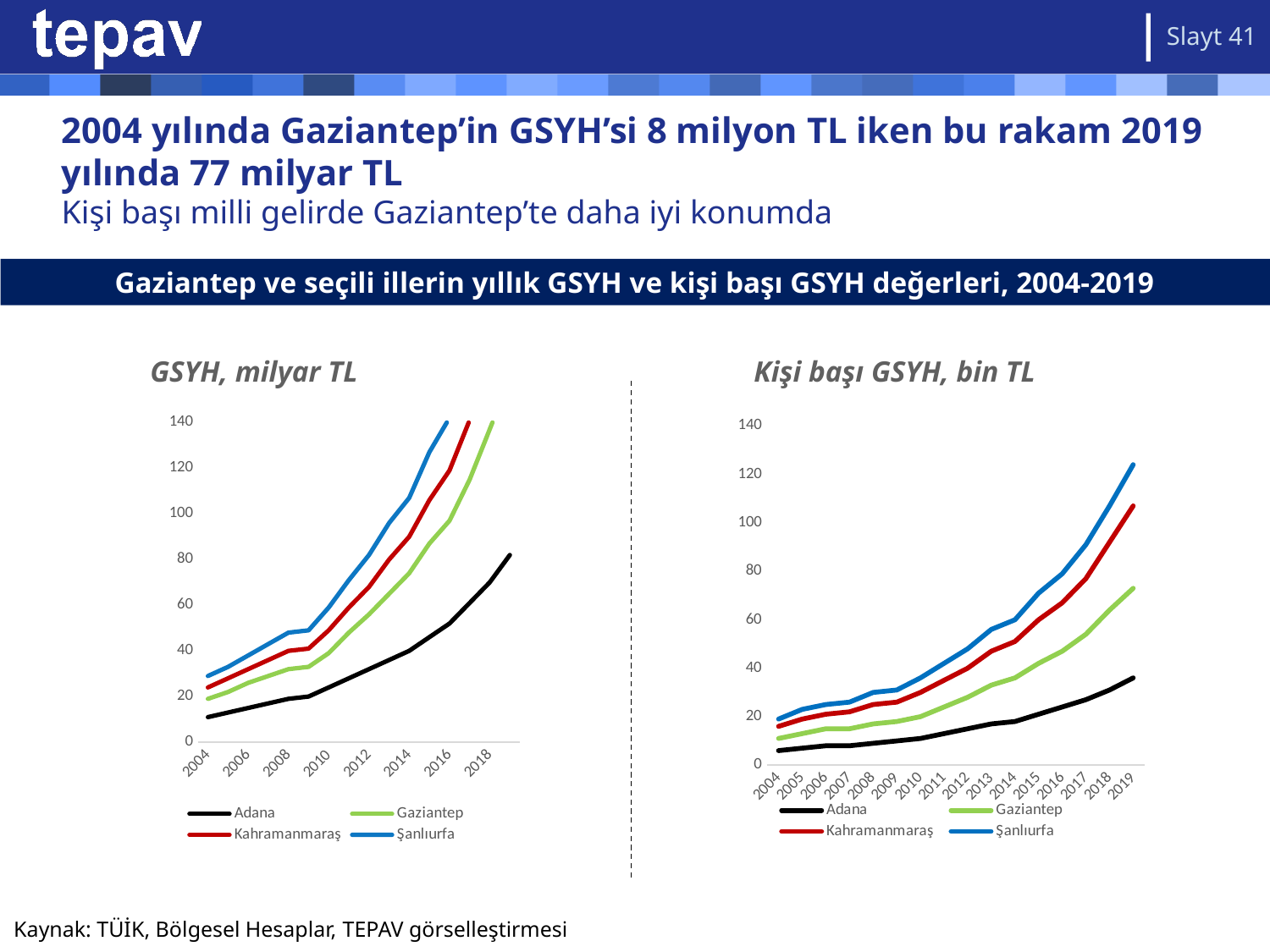
How many years are shown on the x axis of the right chart 'Kişi başı GSYH, bin TL'? 16 In the left chart 'GSYH, milyar TL', which is larger in 2018, the value for Gaziantep or the value for Adana? Gaziantep In the right chart 'Kişi başı GSYH, bin TL', does the Adana series rise or fall from 2004 to 2019? rise Which series is drawn in red in the left chart 'GSYH, milyar TL'? Kahramanmaraş How many series does the legend of the right chart 'Kişi başı GSYH, bin TL' list? 4 In the right chart 'Kişi başı GSYH, bin TL', which series has the lowest value in 2019? Adana In the left chart 'GSYH, milyar TL', is the value for Adana in 2018 greater or less than 100? less In the right chart 'Kişi başı GSYH, bin TL', which series has the highest value in 2019? Şanlıurfa In the left chart 'GSYH, milyar TL', is the value for Adana in 2004 greater or less than 20? less In the right chart 'Kişi başı GSYH, bin TL', is the value for Gaziantep in 2019 greater or less than 80? less What kind of chart is the left chart titled 'GSYH, milyar TL'? line chart